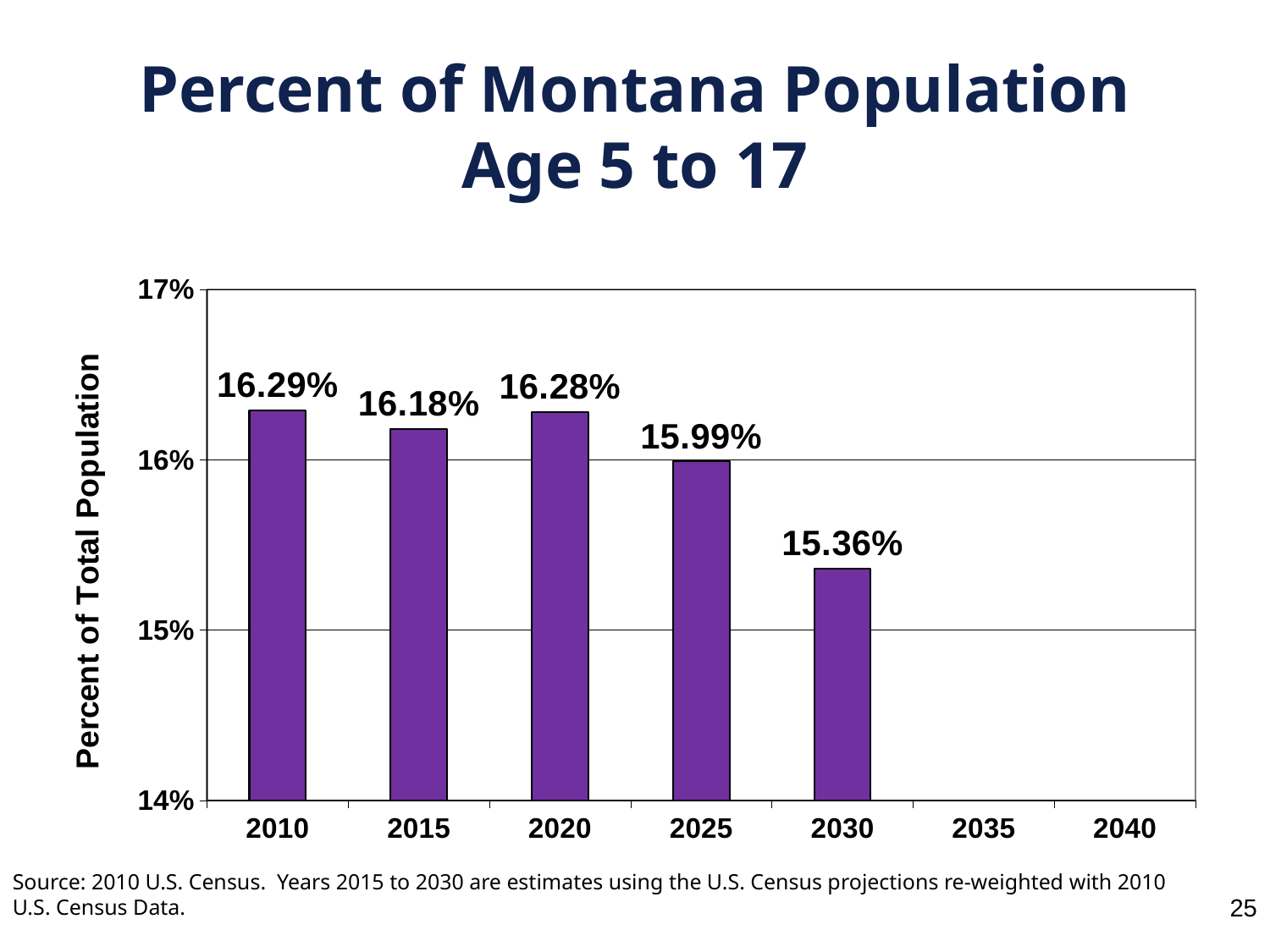
What is the value for 2025? 15.99% What is the value for 2030? 15.36% What is the difference between the values for 2010 and 2030? 0.93% What kind of chart is shown? bar chart What is the value for 2010? 16.29% What is the value for 2015? 16.18% Which is larger, the value for 2015 or the value for 2025? 2015 Which year has the lowest value? 2030 Is the value for 2030 greater or less than 16%? less What is the difference between the values for 2025 and 2030? 0.63% Do the values generally rise or fall from 2020 to 2030? fall How many years have a bar plotted on the chart? 5